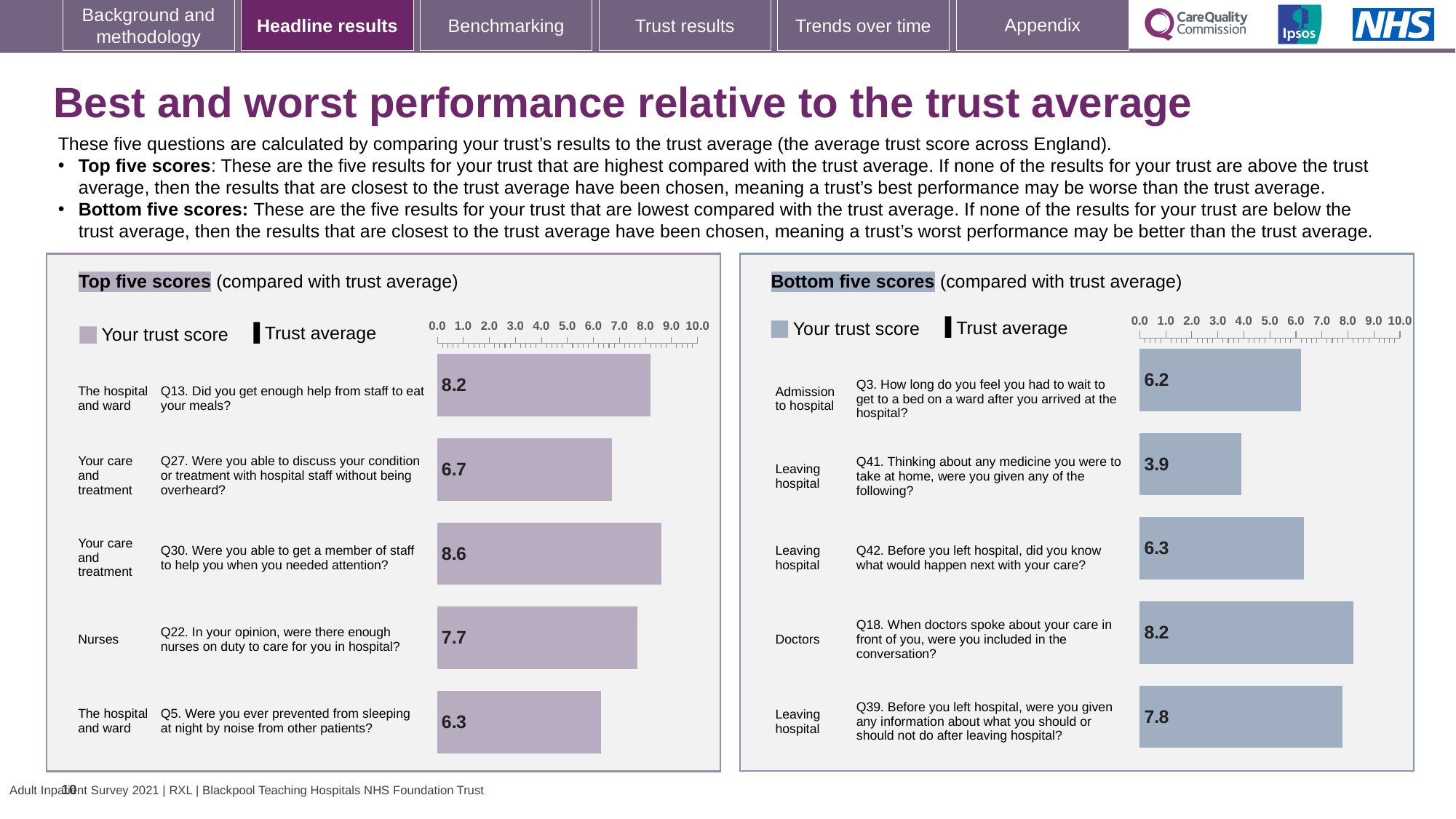
How many questions are plotted in the Bottom five scores chart? 5 In the Bottom five scores chart, what is the trust score for Q41 (medicine to take at home)? 3.9 In the Bottom five scores chart, which is larger: the score for Q18 or the score for Q39? Q18 What kind of chart is the Top five scores chart? Bar chart In the Top five scores chart, is the value for Q22 greater or less than 7.0? greater In the Top five scores chart, which question has the highest trust score? Q30 In the Bottom five scores chart, what is the difference between the scores for Q18 and Q41? 4.3 In the Bottom five scores chart, which question has the lowest trust score? Q41 How many entries does the legend of the Top five scores chart list? 2 In the Top five scores chart, what is the trust score for Q5 (prevented from sleeping by noise from other patients)? 6.3 In the Top five scores chart, what is the difference between the scores for Q30 and Q5? 2.3 In the Top five scores chart, what is the trust score for Q30 (getting a member of staff to help when you needed attention)? 8.6